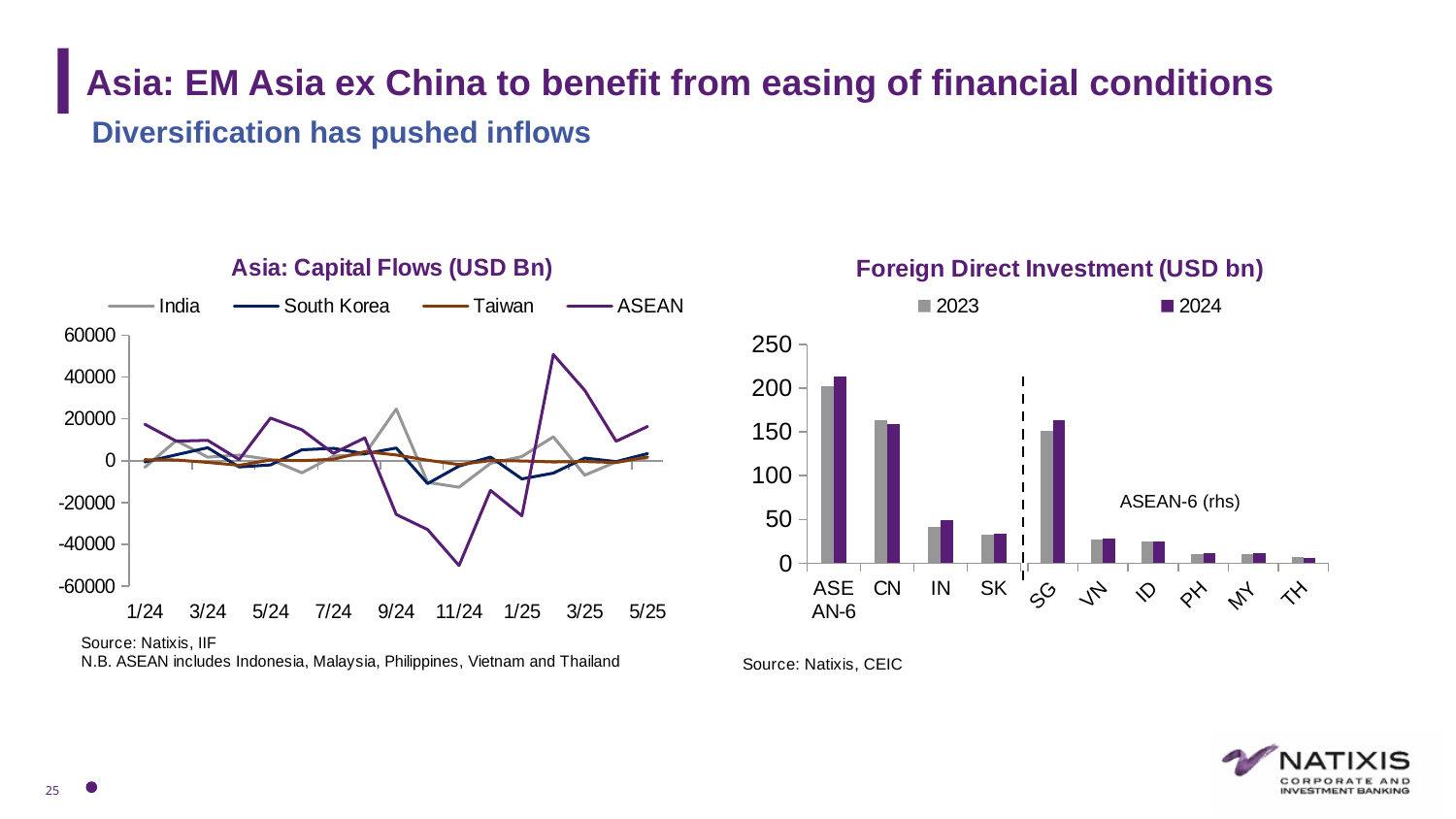
Which series in the 'Asia: Capital Flows (USD Bn)' chart is drawn in purple? ASEAN In the 'Foreign Direct Investment (USD bn)' chart, is the 2023 value for IN greater or less than 50? less In the 'Foreign Direct Investment (USD bn)' chart, which is larger, the 2024 value for CN or the 2024 value for IN? CN How many series does the legend of the 'Asia: Capital Flows (USD Bn)' chart list? 4 In the 'Asia: Capital Flows (USD Bn)' chart, which series reaches the lowest value on the chart? ASEAN What kind of chart is the 'Foreign Direct Investment (USD bn)' chart? bar chart In the 'Foreign Direct Investment (USD bn)' chart, which category has the tallest bar? ASEAN-6 What kind of chart is the 'Asia: Capital Flows (USD Bn)' chart? line chart How many series does the legend of the 'Foreign Direct Investment (USD bn)' chart list? 2 In the 'Asia: Capital Flows (USD Bn)' chart, is the peak value of the ASEAN line in early 2025 greater or less than 40000? greater In the 'Foreign Direct Investment (USD bn)' chart, is the 2023 value for CN greater or less than 150? greater How many categories are shown on the x axis of the 'Foreign Direct Investment (USD bn)' chart? 10